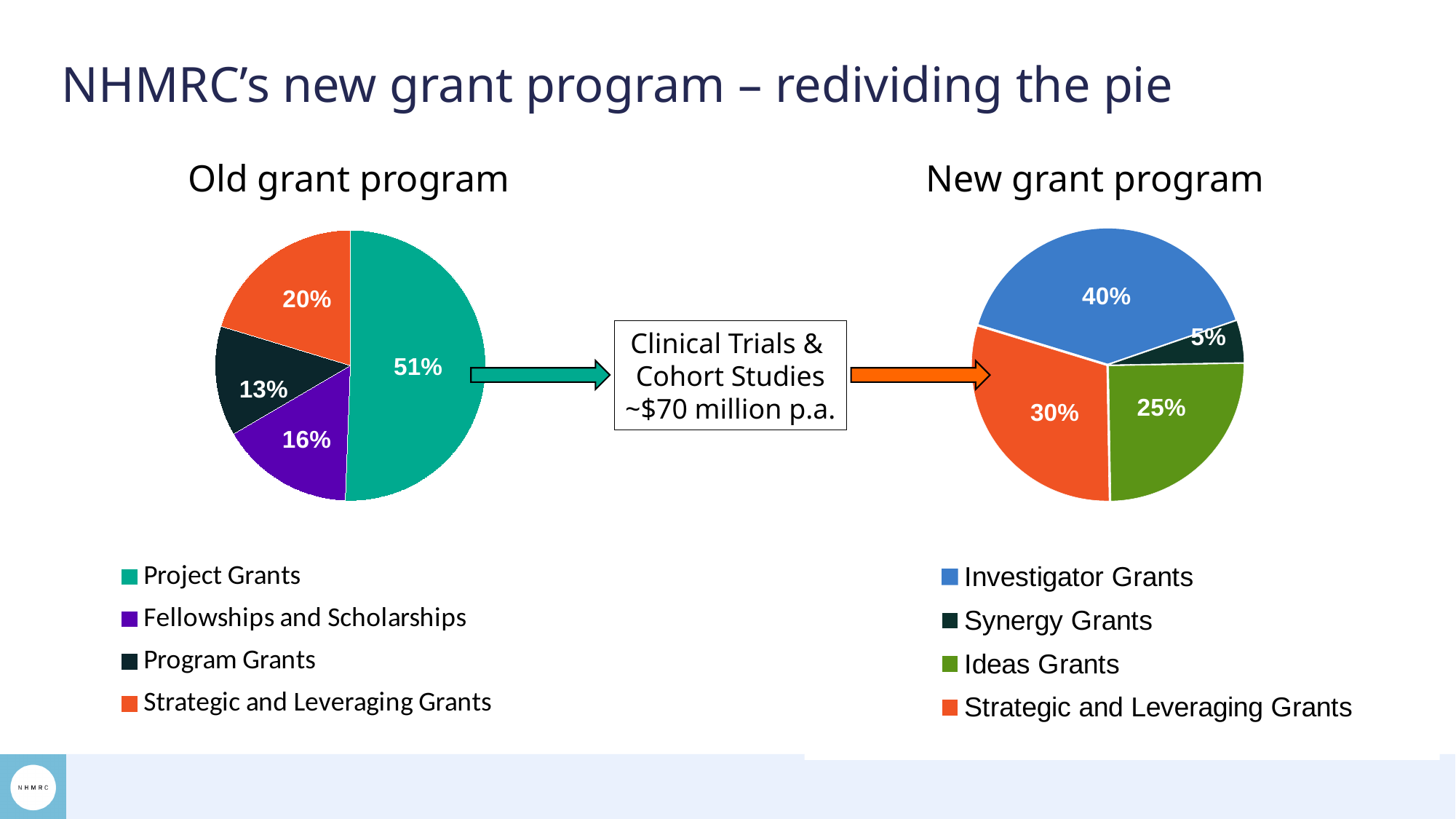
In the New grant program chart, which category has the largest share? Investigator Grants In the Old grant program chart, which is larger: Strategic and Leveraging Grants or Program Grants? Strategic and Leveraging Grants Which category appears in the legends of both the Old grant program and New grant program charts? Strategic and Leveraging Grants In the New grant program chart, what is the difference in percentage points between Strategic and Leveraging Grants and Ideas Grants? 5 In the Old grant program chart, what share do Project Grants have? 51% In the Old grant program chart, which category has the smallest share? Program Grants In the Old grant program chart, what share do Fellowships and Scholarships have? 16% What kind of chart is the Old grant program chart? Pie chart In the Old grant program chart, what is the combined share of Fellowships and Scholarships and Program Grants? 29% In the New grant program chart, what share do Investigator Grants have? 40% How many categories does the New grant program chart show? 4 In the New grant program chart, what share do Synergy Grants have? 5%